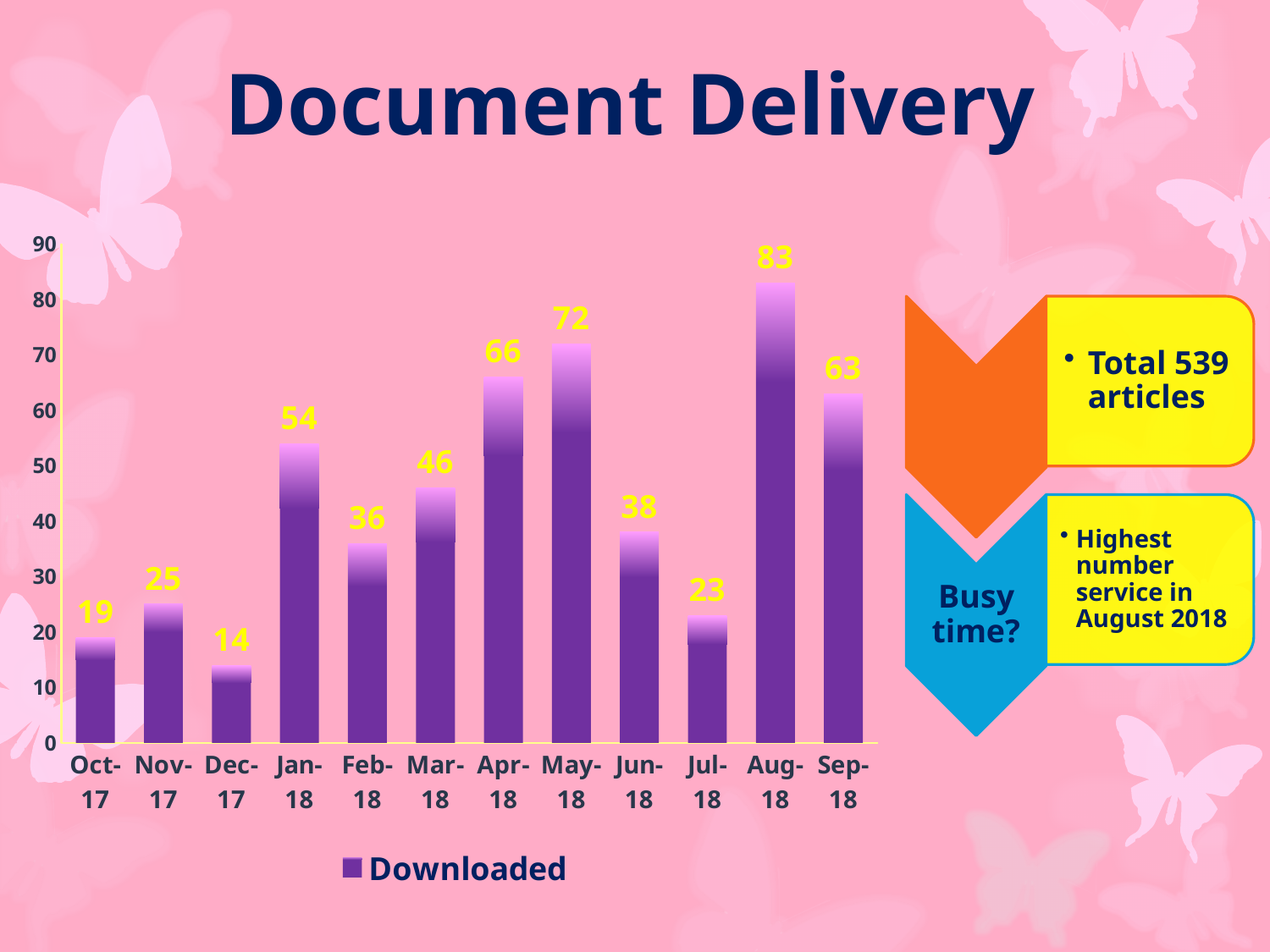
What is the value for Apr-18? 66 How many series does the legend list? 1 What is the value for Dec-17? 14 Which month has the lowest value? Dec-17 Which month has the highest value? Aug-18 What is the name of the series in the legend? Downloaded Which is larger, the value for Jan-18 or the value for Mar-18? Jan-18 What is the difference between the values for May-18 and Jun-18? 34 How many months are shown on the x axis? 12 What kind of chart is shown? bar chart Is the value for Sep-18 greater or less than 60? greater What is the value for Aug-18? 83